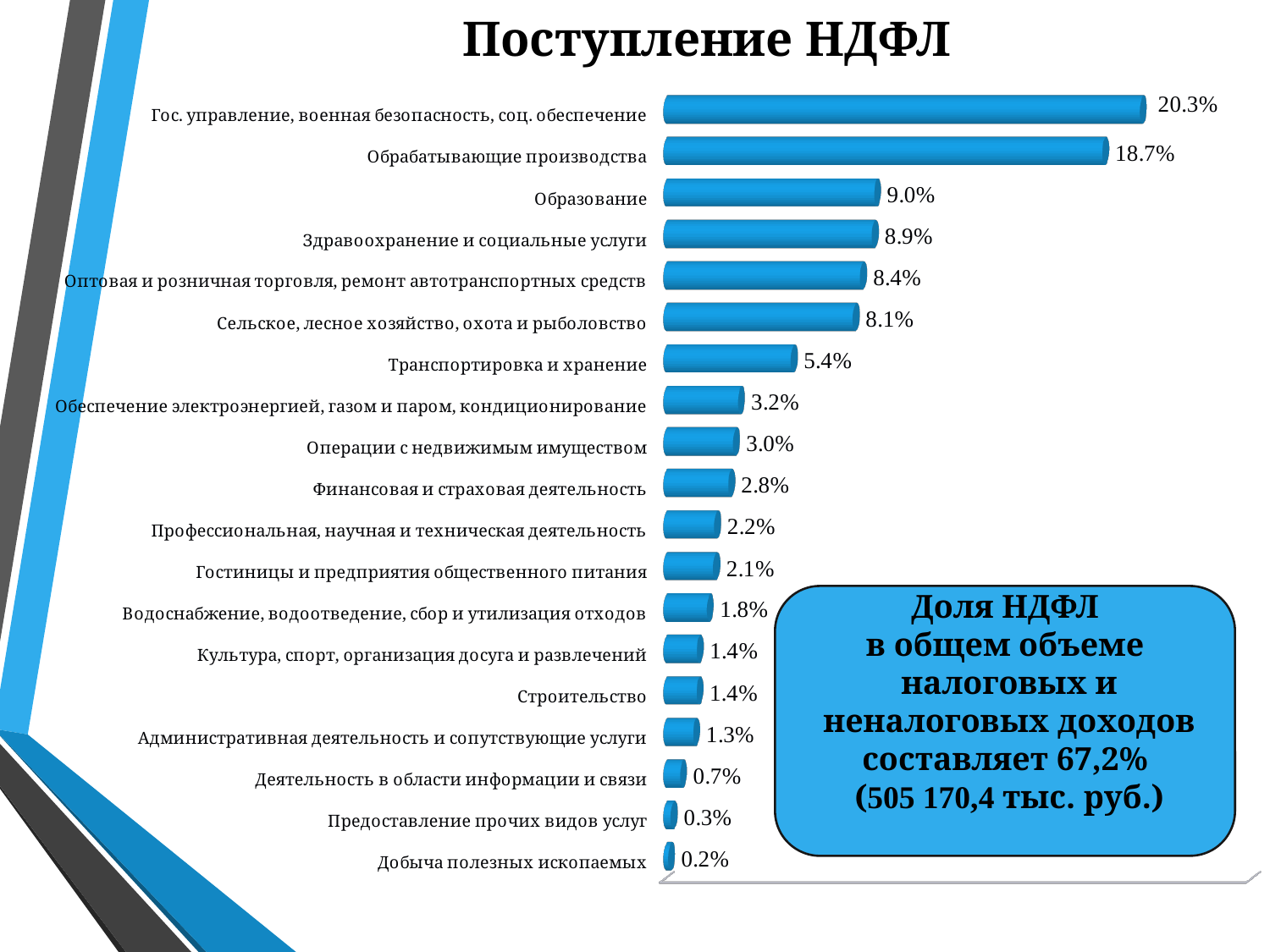
What is the difference between the values for Образование and Здравоохранение и социальные услуги? 0.1% What is the title of the slide? Поступление НДФЛ What is the difference between the values for Гос. управление, военная безопасность, соц. обеспечение and Обрабатывающие производства? 1.6% What kind of chart is shown on the slide? Bar chart Which category has the highest value? Гос. управление, военная безопасность, соц. обеспечение Which is larger: the value for Сельское, лесное хозяйство, охота и рыболовство or the value for Транспортировка и хранение? Сельское, лесное хозяйство, охота и рыболовство Which category has the lowest value? Добыча полезных ископаемых What is the value for Деятельность в области информации и связи? 0.7% What is the value for Транспортировка и хранение? 5.4% What is the value for Строительство? 1.4% How many categories are shown in the chart? 19 What is the value for Образование? 9.0%